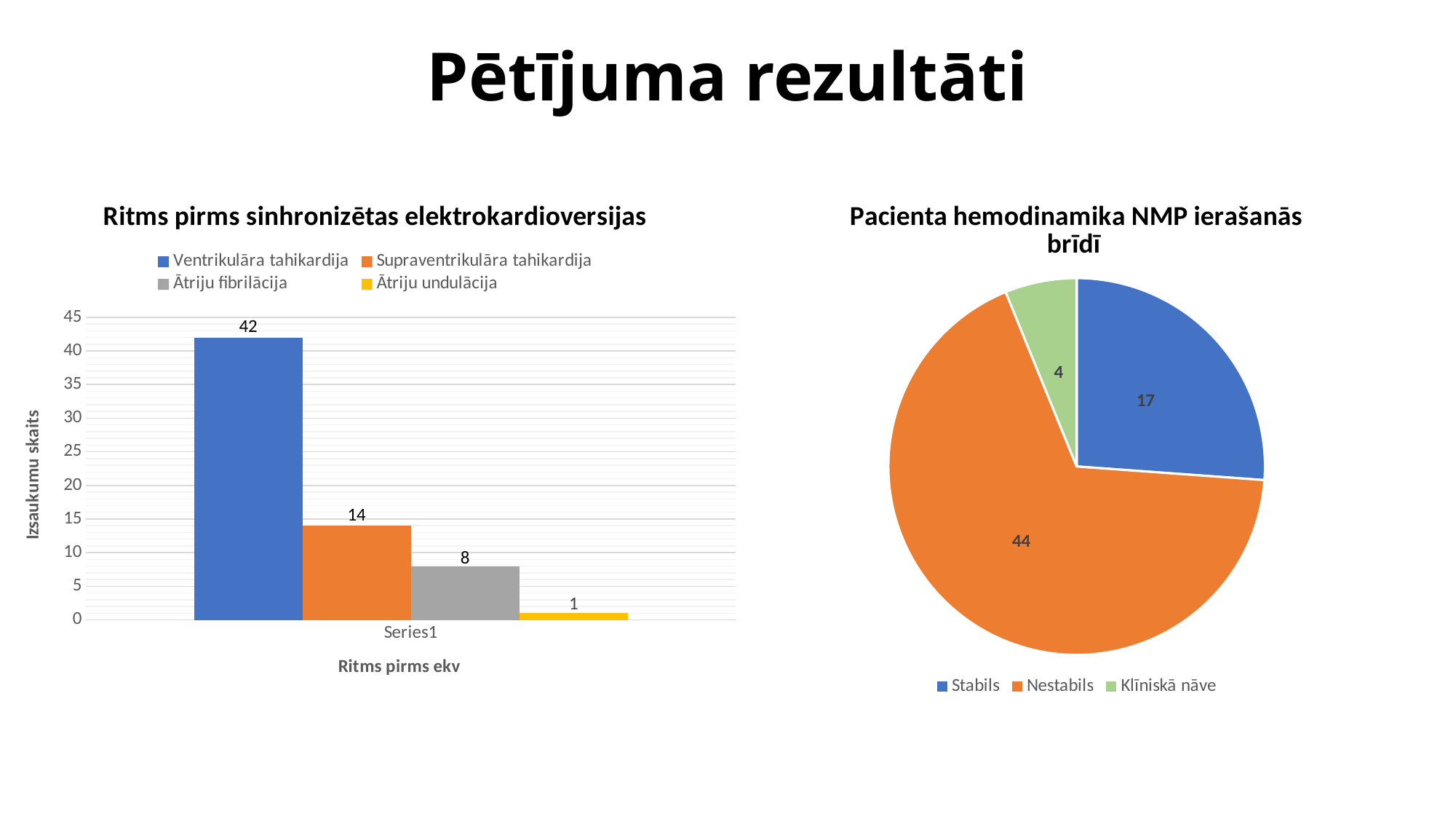
What kind of chart is 'Ritms pirms sinhronizētas elektrokardioversijas'? bar chart In the pie chart 'Pacienta hemodinamika NMP ierašanās brīdī', what is the value for Nestabils? 44 What is the y-axis title of the bar chart 'Ritms pirms sinhronizētas elektrokardioversijas'? Izsaukumu skaits In the bar chart 'Ritms pirms sinhronizētas elektrokardioversijas', how many series does the legend list? 4 In the bar chart 'Ritms pirms sinhronizētas elektrokardioversijas', what is the value for Ventrikulāra tahikardija? 42 In the bar chart 'Ritms pirms sinhronizētas elektrokardioversijas', which series has the lowest value? Ātriju undulācija In the bar chart 'Ritms pirms sinhronizētas elektrokardioversijas', which series has the highest value? Ventrikulāra tahikardija In the bar chart 'Ritms pirms sinhronizētas elektrokardioversijas', what is the difference between Ventrikulāra tahikardija and Supraventrikulāra tahikardija? 28 In the bar chart 'Ritms pirms sinhronizētas elektrokardioversijas', what is the value for Ātriju fibrilācija? 8 In the pie chart 'Pacienta hemodinamika NMP ierašanās brīdī', how many slices are there? 3 In the pie chart 'Pacienta hemodinamika NMP ierašanās brīdī', which category has the smallest slice? Klīniskā nāve In the pie chart 'Pacienta hemodinamika NMP ierašanās brīdī', which is larger, Stabils or Klīniskā nāve? Stabils